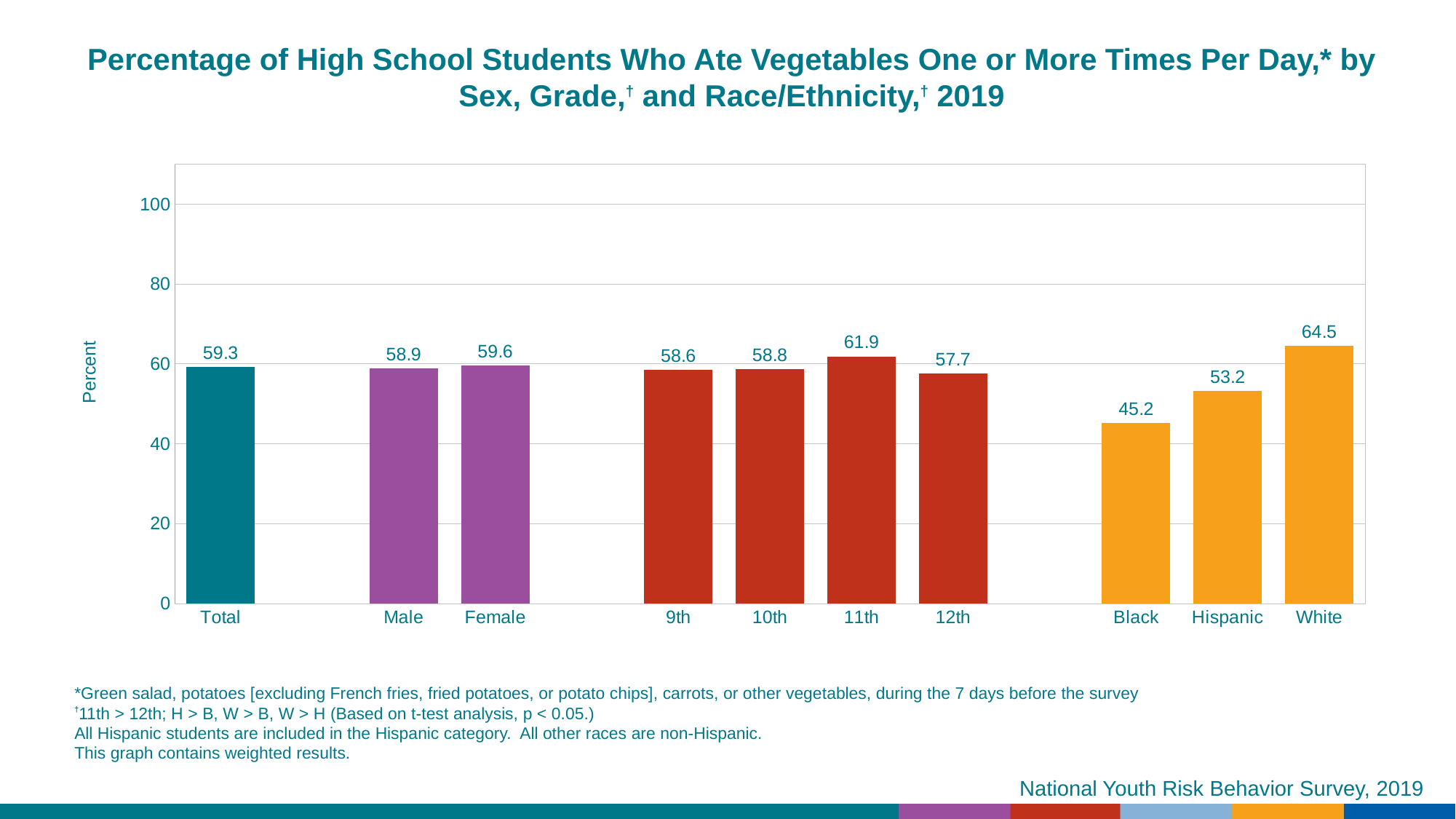
How many categories are shown on the x axis? 10 Which category has the highest value on the chart? White What is the value for 11th grade students? 61.9 What is the difference between the values for White and Black students? 19.3 What percentage of high school students in total ate vegetables one or more times per day? 59.3 What is the difference between the values for Female and Male students? 0.7 What is the value for Black students? 45.2 What is the label of the y axis? Percent What kind of chart is shown on the slide? bar chart Is the value for 12th grade students greater or less than 60? less Which category has the lowest value on the chart? Black Which is larger, the value for Hispanic students or the value for Black students? Hispanic